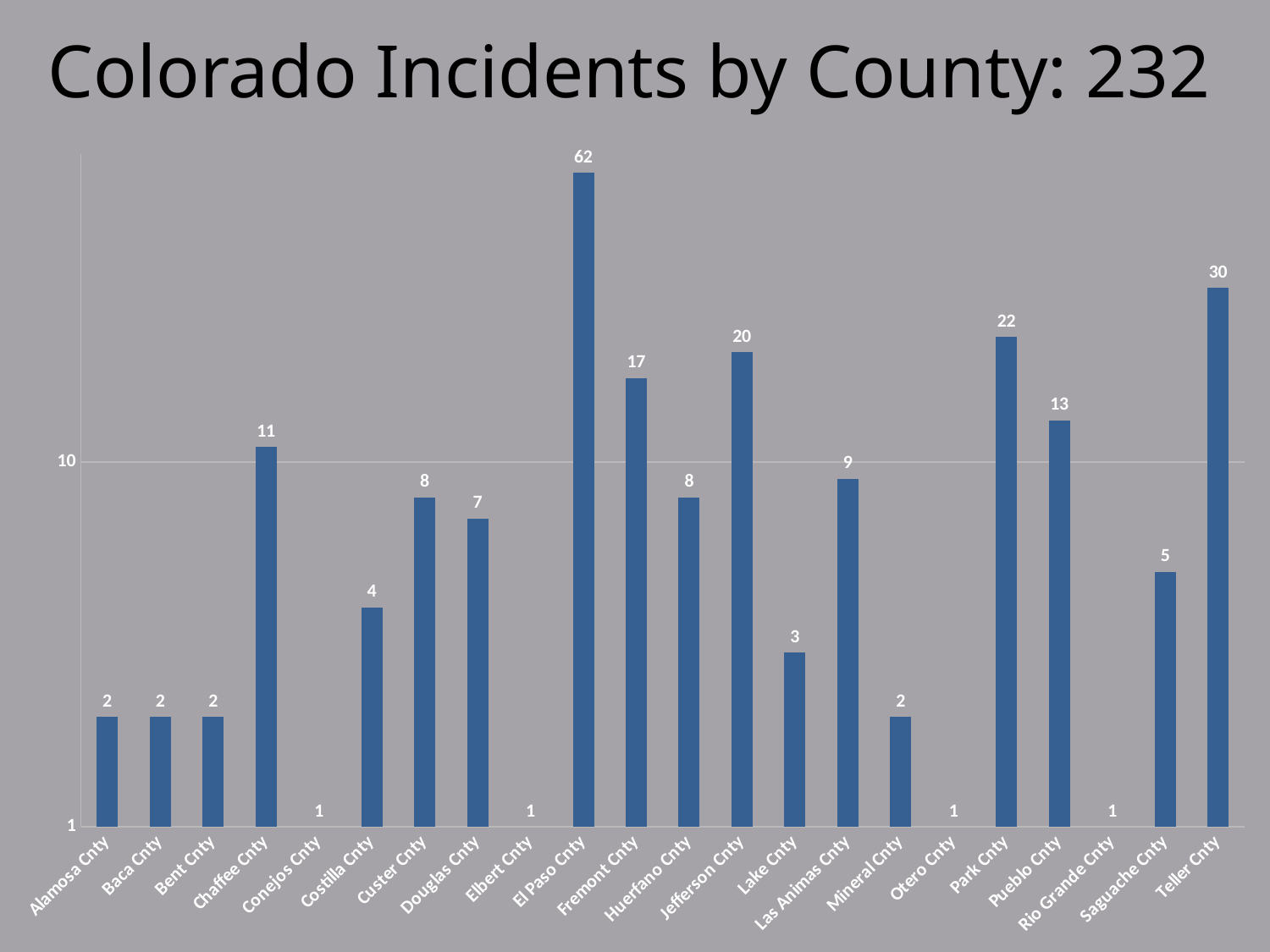
What kind of chart is shown on the slide? Bar chart What is the value for Teller Cnty? 30 How many counties are shown on the x axis? 22 How many incidents are shown for El Paso Cnty? 62 What is the difference between the values for El Paso Cnty and Teller Cnty? 32 What is the title of the chart? Colorado Incidents by County: 232 Which has a larger value, Jefferson Cnty or Fremont Cnty? Jefferson Cnty What is the value for Saguache Cnty? 5 Which has a larger value, Las Animas Cnty or Douglas Cnty? Las Animas Cnty Which county has the highest number of incidents? El Paso Cnty What is the value for Chaffee Cnty? 11 What is the difference between the values for Park Cnty and Pueblo Cnty? 9